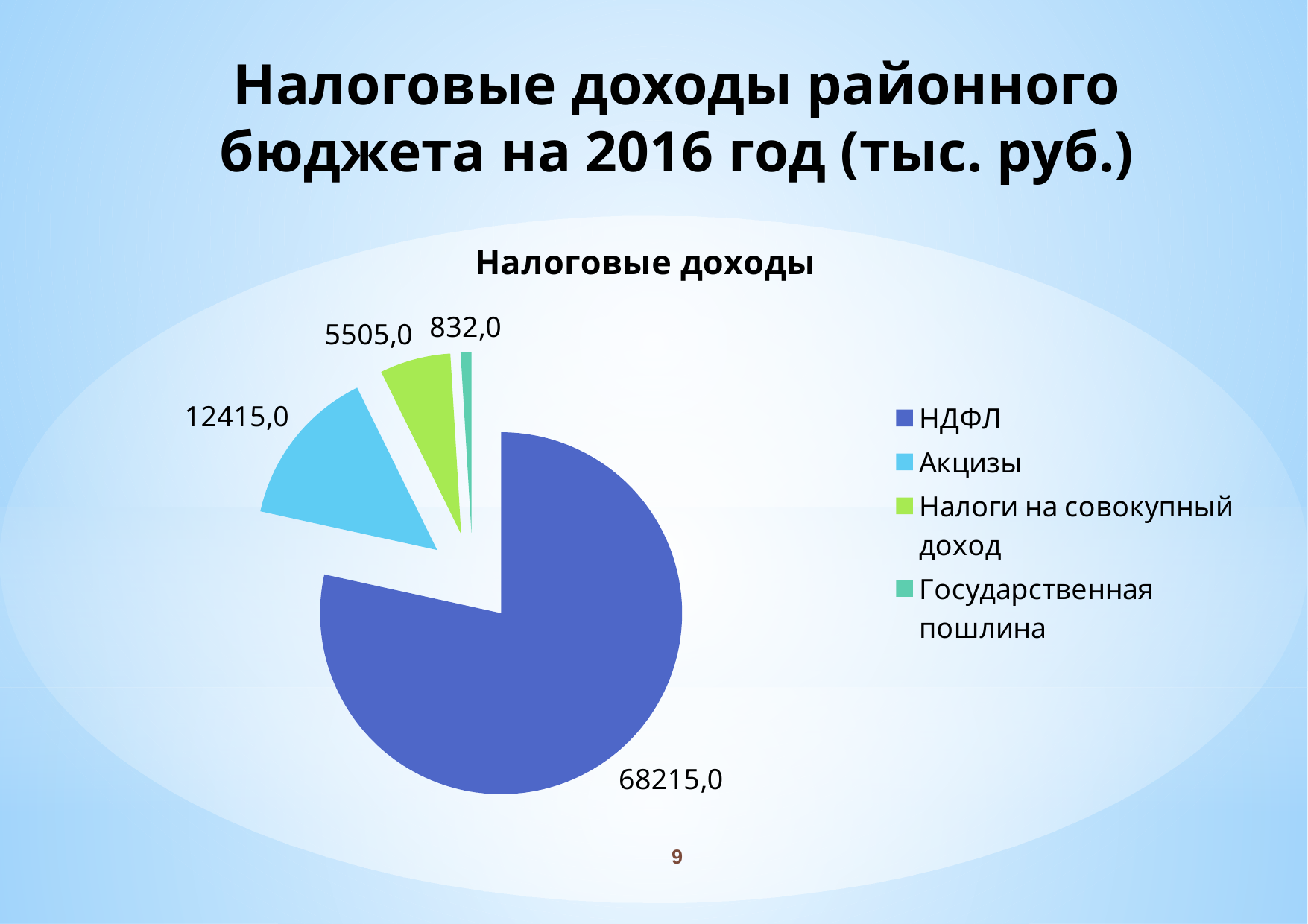
Which category has the smallest slice in the pie chart? Государственная пошлина What is the value for Налоги на совокупный доход in the pie chart? 5505,0 Which is larger, the value for Акцизы or the value for Налоги на совокупный доход? Акцизы Which category has the largest slice in the pie chart? НДФЛ What is the value for НДФЛ in the pie chart? 68215,0 What is the difference between the values for Налоги на совокупный доход and Государственная пошлина? 4673,0 What type of chart is shown on the slide? Pie chart What is the difference between the values for НДФЛ and Акцизы? 55800,0 What is the value for Акцизы in the pie chart? 12415,0 What is the title of the chart on the slide? Налоговые доходы How many categories does the pie chart show? 4 What is the value for Государственная пошлина in the pie chart? 832,0